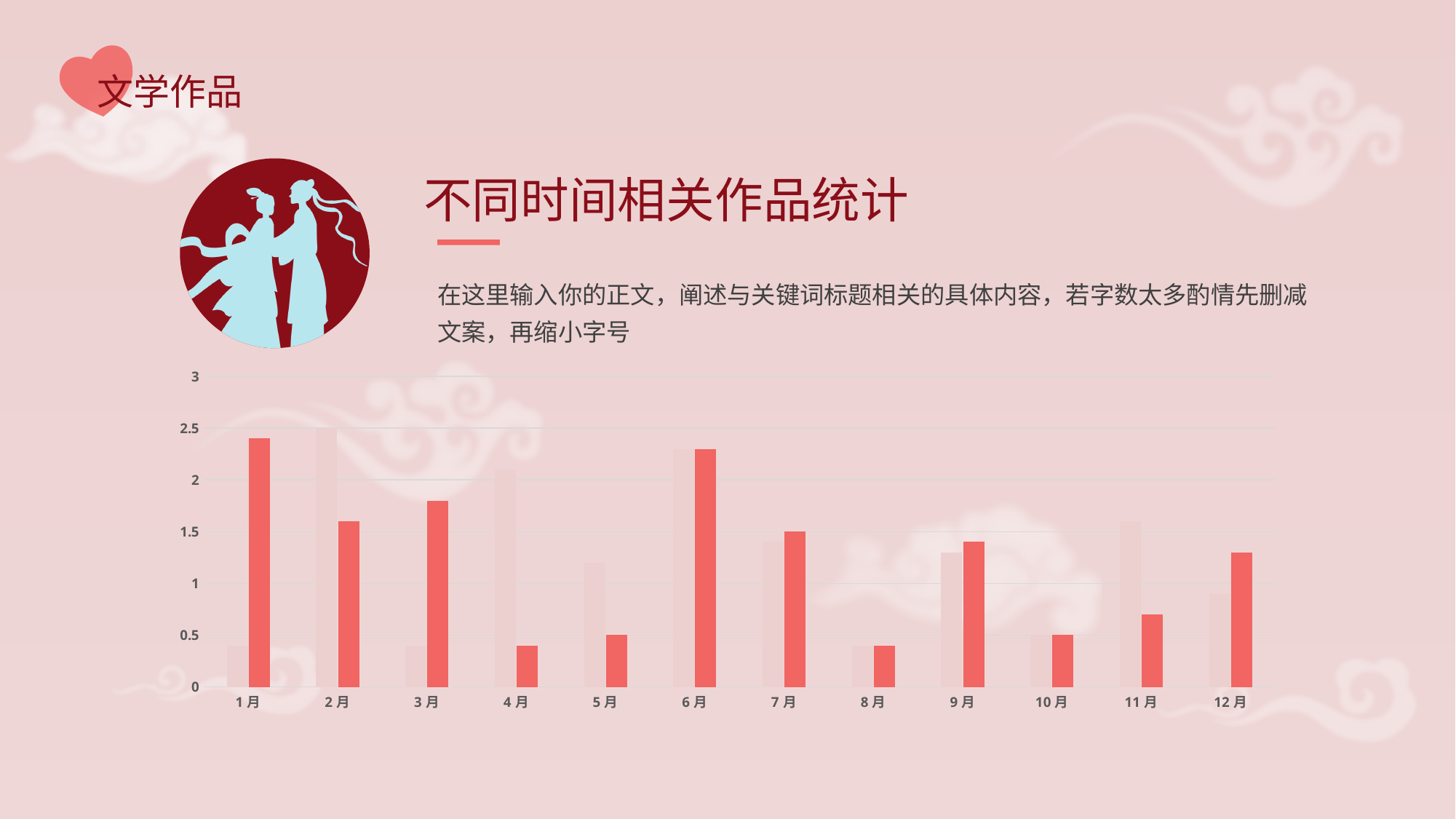
Is the red bar for 12月 greater or less than 1? greater How many months are shown on the x axis of the chart? 12 What is the title of the chart section on the slide? 不同时间相关作品统计 What is the highest value shown on the chart's vertical axis? 3 Is the red bar for 1月 greater or less than 2? greater Is the red bar for 3月 greater or less than 1.5? greater Which has the taller red bar, 8月 or 6月? 6月 What kind of chart is shown on the slide? bar chart Which has the taller red bar, 1月 or 4月? 1月